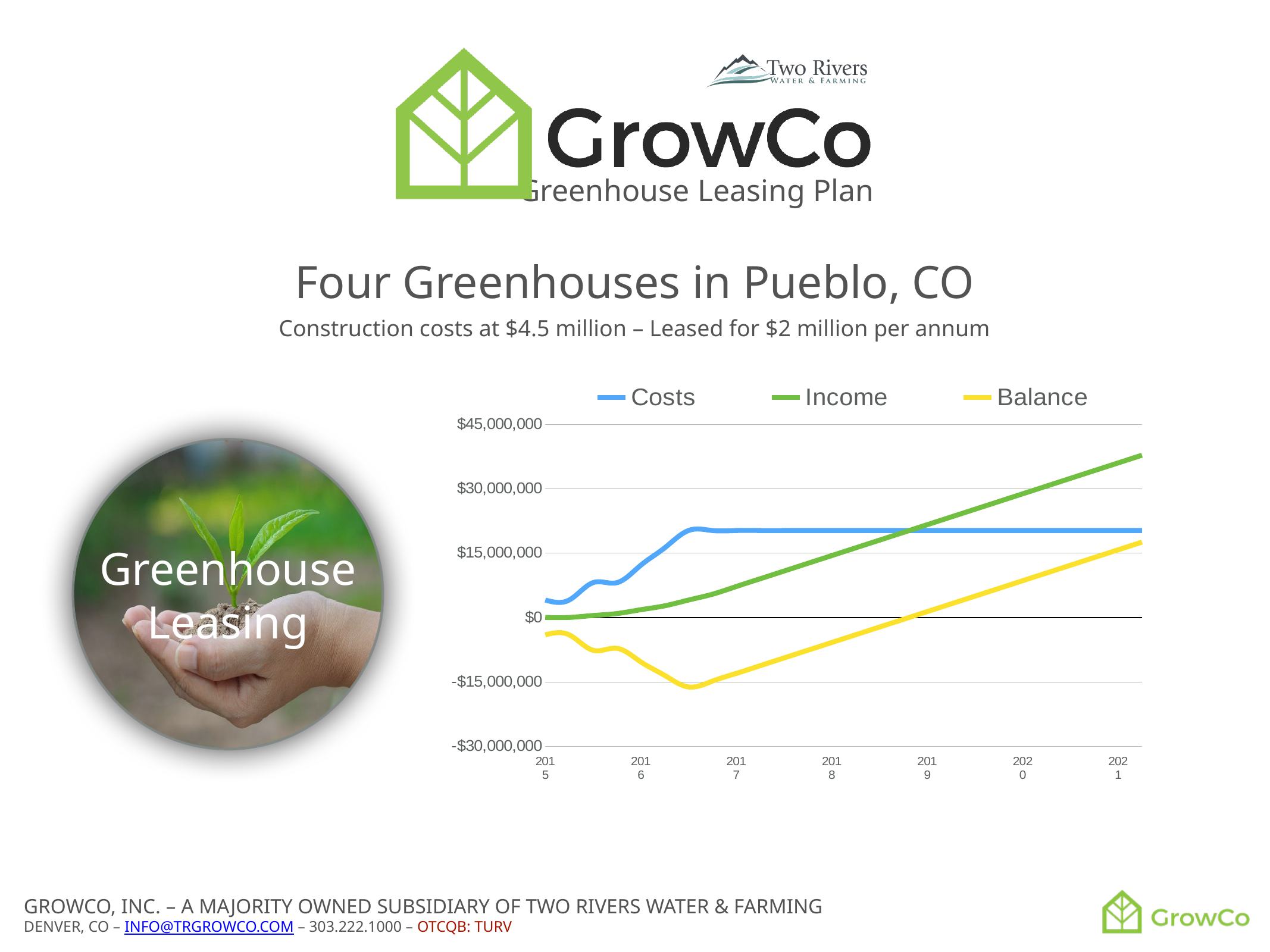
Is the Balance value at 2016 greater or less than $0? less Does the Income line rise or fall from 2015 to 2021? rises Which series has the lowest value at 2016? Balance At 2016, which is larger, Costs or Income? Costs What are the series names listed in the chart's legend? Costs, Income, Balance How many series does the chart's legend list? 3 Is the Income value at 2021 greater or less than $30,000,000? greater At 2021, which is larger, Income or Costs? Income How many years are labelled on the chart's x axis? 7 Is the Costs value at 2021 greater or less than $15,000,000? greater What kind of chart is shown on the slide? line chart Which series has the highest value at 2021? Income